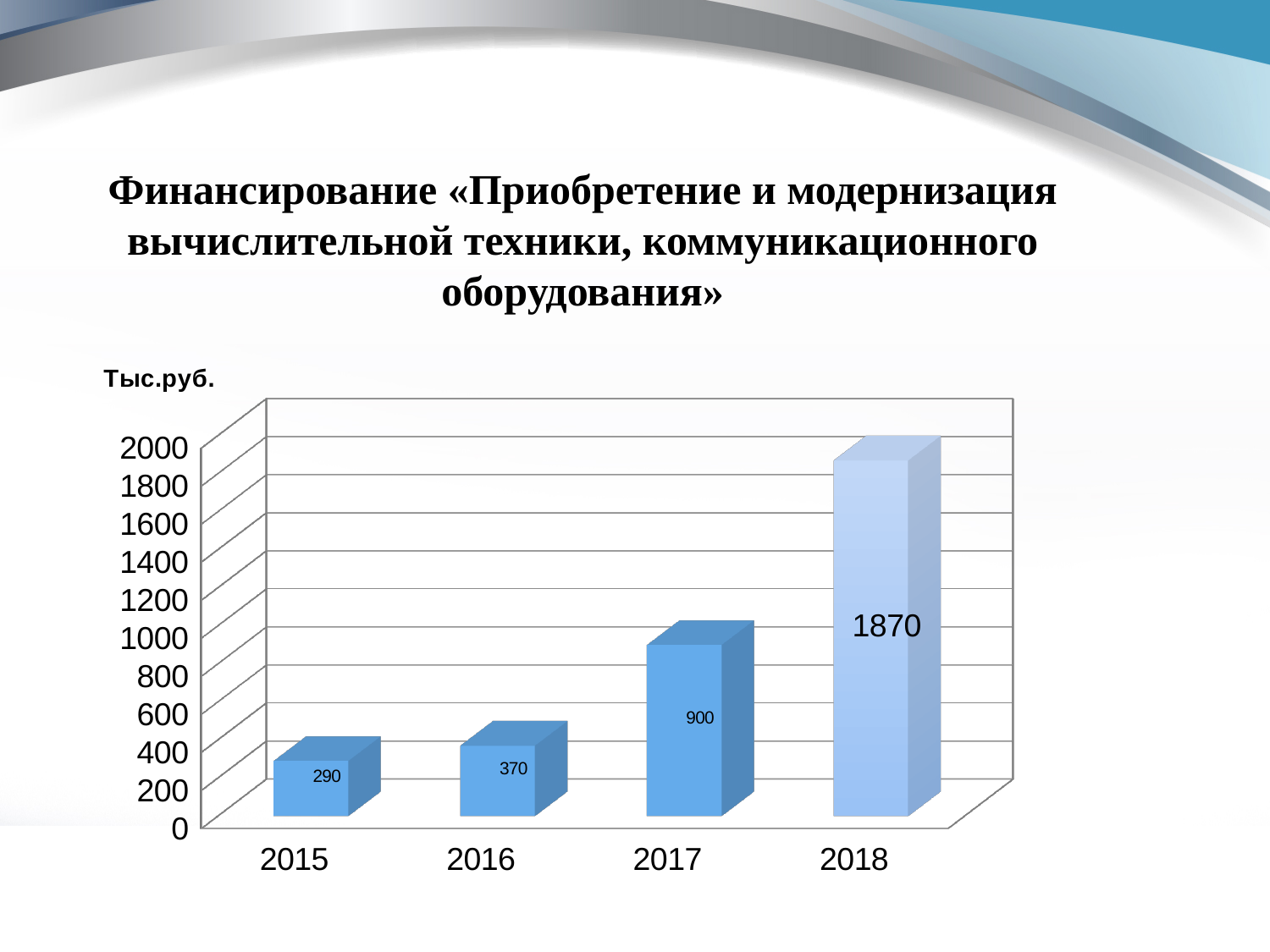
Which year has the lowest value? 2015 Which year has the highest value? 2018 What is the difference between the values for 2018 and 2017? 970 How many years are shown on the x axis? 4 Which is larger, the value for 2017 or the value for 2016? 2017 What is the value for 2016? 370 What is the value for 2015? 290 What is the value for 2018? 1870 What is the difference between the values for 2016 and 2015? 80 Do the values rise or fall from 2015 to 2018? rise What kind of chart is shown on the slide? bar chart What is the value for 2017? 900